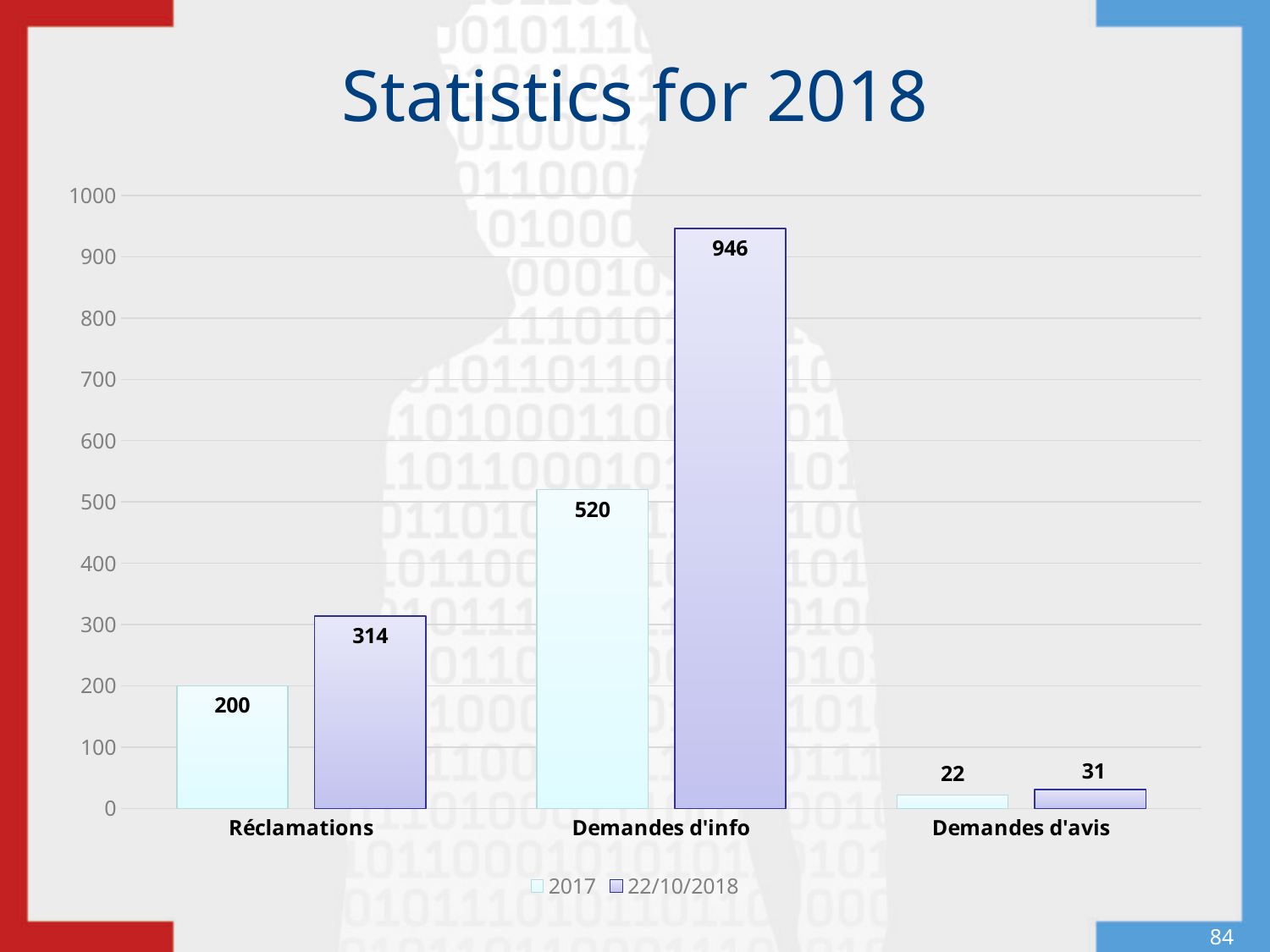
What is the difference between the 22/10/2018 and 2017 values for Demandes d'info? 426 Which category has the highest value in the 22/10/2018 series? Demandes d'info How many categories are shown on the x axis? 3 What is the value for Réclamations in the 2017 series? 200 What is the value for Demandes d'avis in the 2017 series? 22 Is the 22/10/2018 value for Réclamations greater or less than 300? greater How many series does the legend list? 2 Which category has the lowest value in the 2017 series? Demandes d'avis What is the difference between the 22/10/2018 and 2017 values for Réclamations? 114 What is the value for Demandes d'info in the 22/10/2018 series? 946 Which is larger for Demandes d'avis: the 2017 value or the 22/10/2018 value? 22/10/2018 What kind of chart is shown on the slide? Bar chart